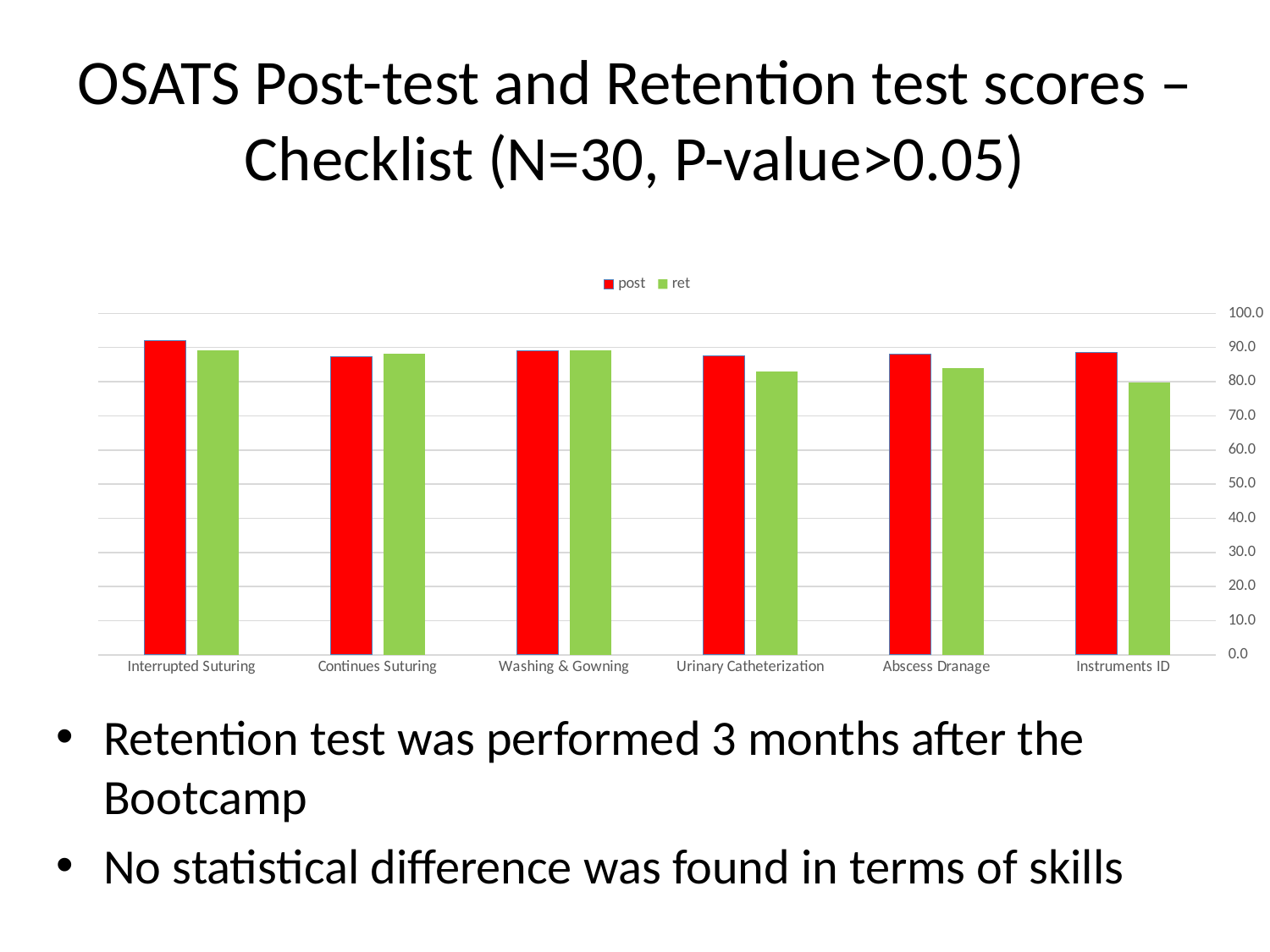
Which category has the lowest ret score? Instruments ID Is the ret value for Abscess Dranage greater or less than 90? less What are the two series named in the chart legend? post and ret How many skill categories are shown on the x axis of the chart? 6 What colour are the bars for the post series? red Is the post value for Continues Suturing greater or less than 80? greater Which category has the highest post score? Interrupted Suturing What kind of chart is shown on the slide? bar chart For Urinary Catheterization, which is larger, the post score or the ret score? post For Instruments ID, which is larger, the post score or the ret score? post Is the ret value for Instruments ID greater or less than 90? less How many series does the chart legend list? 2